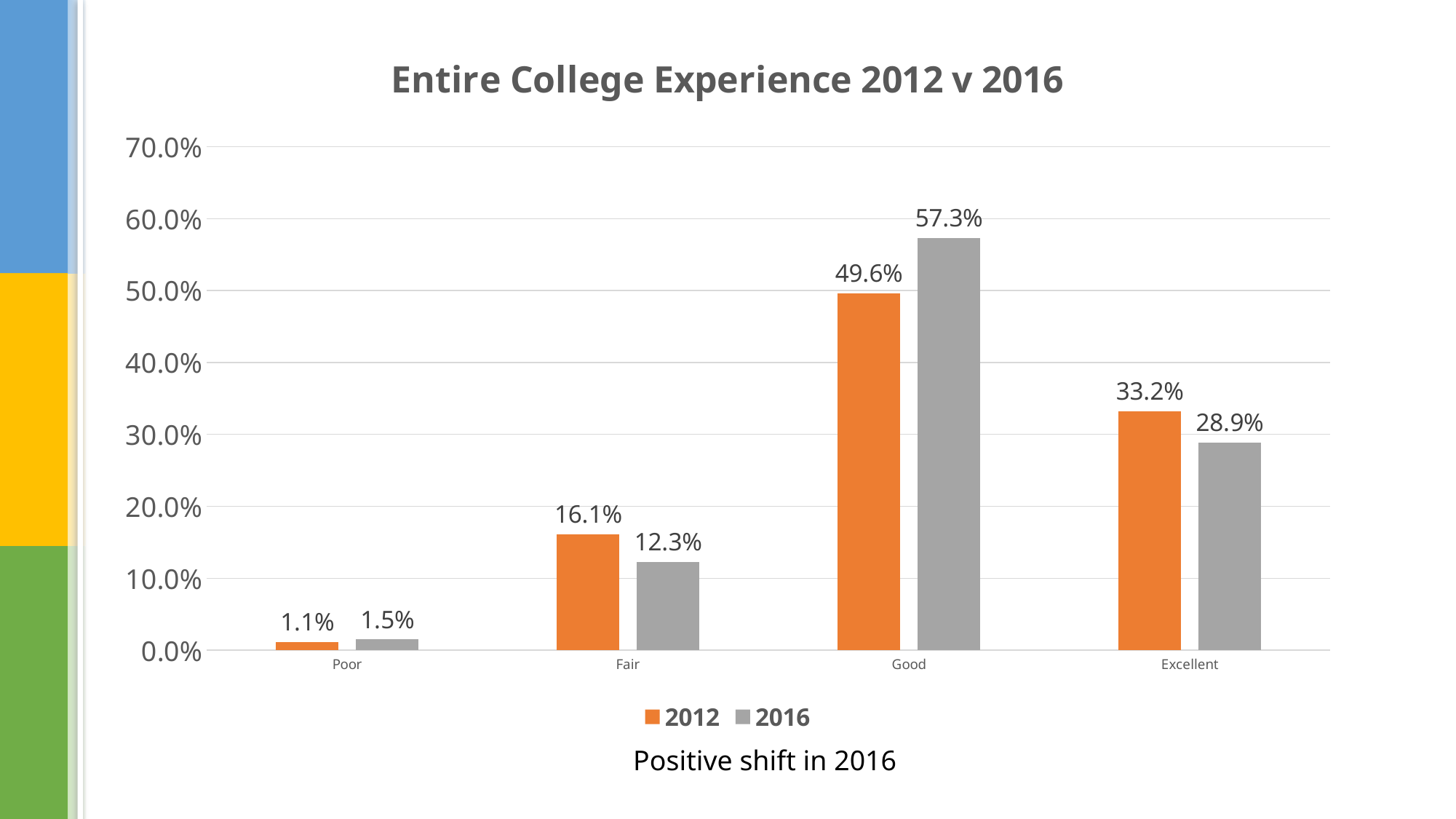
What is the 2016 value for Excellent? 28.9% What is the 2016 value for Good? 57.3% Which category has the highest 2012 value? Good What is the 2012 value for Fair? 16.1% What is the difference between the 2016 and 2012 values for Good? 7.7% How many series does the legend list? 2 Which category has the lowest 2016 value? Poor Is the 2016 value for Fair greater or less than 10.0%? greater How many categories are shown on the x axis? 4 Which is larger for Excellent, the 2012 value or the 2016 value? 2012 What is the title of the chart? Entire College Experience 2012 v 2016 What kind of chart is shown? bar chart